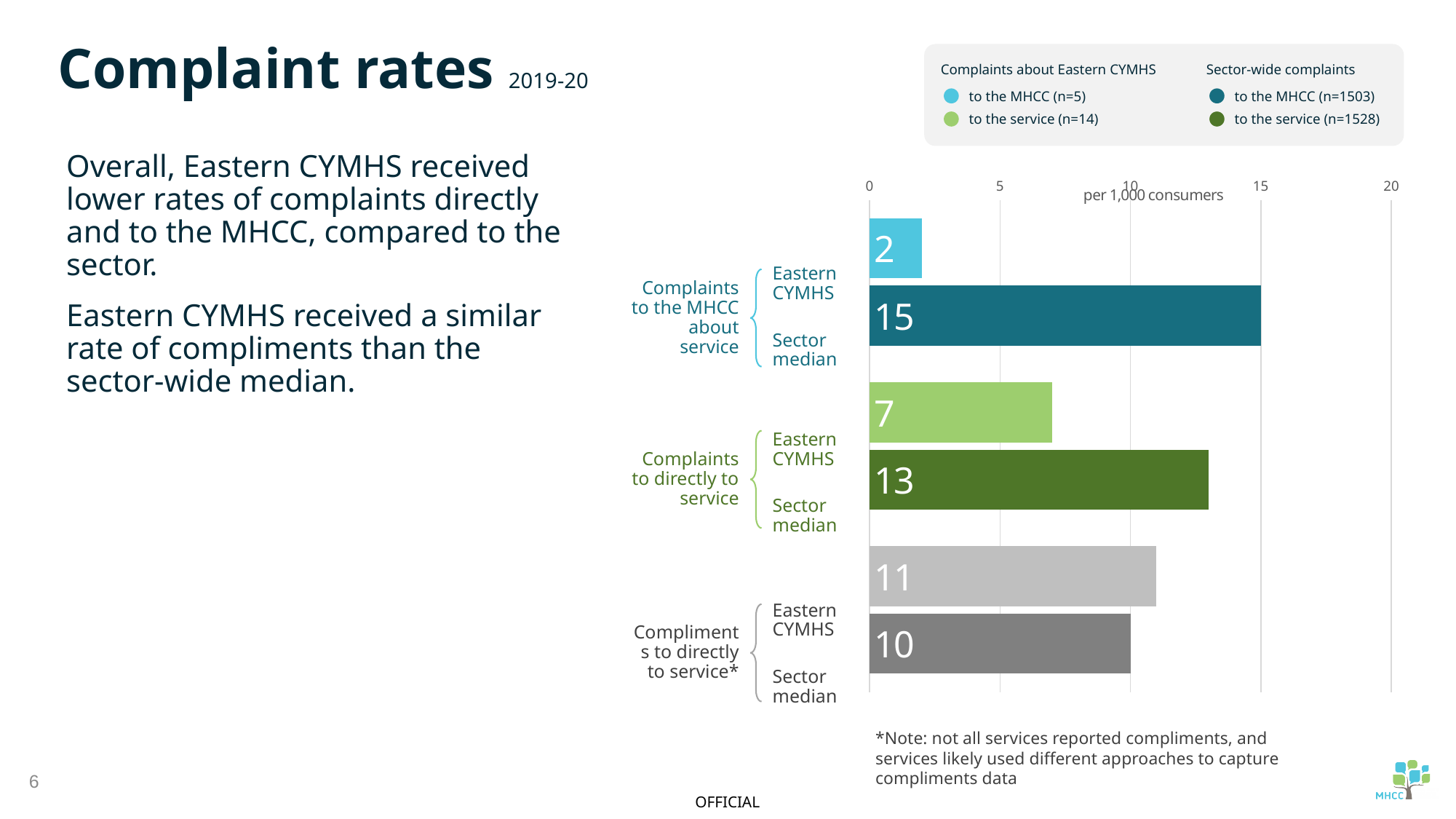
Is the sector median value for complaints directly to service greater or less than 10? greater How many bars are plotted on the chart? 6 What unit does the x axis of the chart use? per 1,000 consumers What is the difference between the sector median and Eastern CYMHS for complaints directly to service? 6 What is the rate of complaints to the MHCC about service for Eastern CYMHS? 2 What is the sector median rate of complaints to the MHCC about service? 15 What is the rate of complaints directly to service for Eastern CYMHS? 7 For compliments directly to service, which is larger: Eastern CYMHS or the sector median? Eastern CYMHS What is the sector median rate of compliments directly to service? 10 What type of chart is shown on the slide? Bar chart Which bar has the lowest value on the chart? Eastern CYMHS, complaints to the MHCC about service Which bar has the highest value on the chart? Sector median, complaints to the MHCC about service